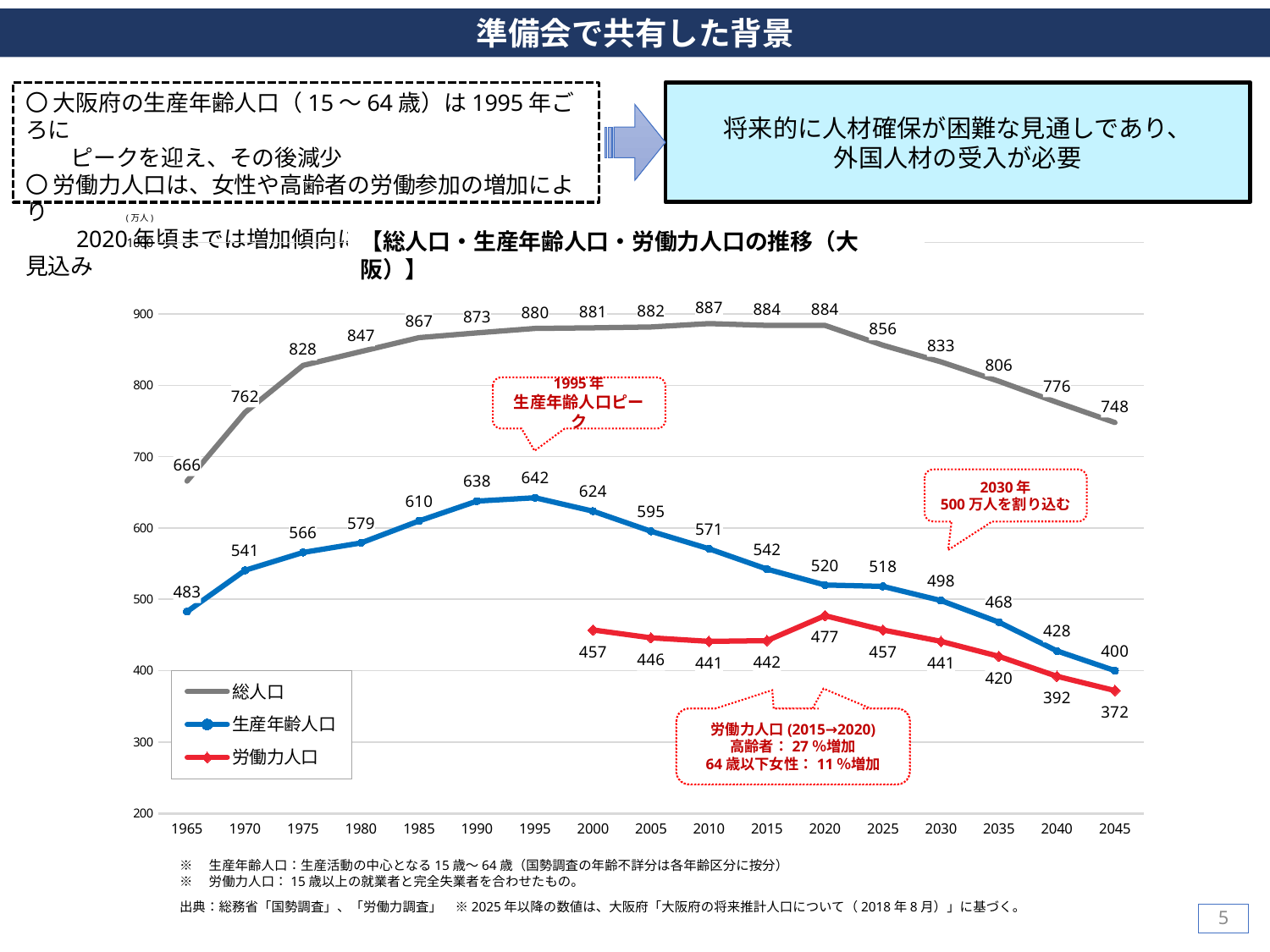
What kind of chart is shown on the slide? line chart How many series does the legend list? 3 In which year is 総人口 at its lowest value? 1965 What is the value of 総人口 in 2010? 887 How many years are shown on the x axis? 17 What is the value of 労働力人口 in 2020? 477 What is the difference between 総人口 and 生産年齢人口 in 2045? 348 What is the value of 生産年齢人口 in 1995? 642 What is the difference between 生産年齢人口 in 1995 and in 2045? 242 In which year does 生産年齢人口 reach its highest value? 1995 Does 総人口 rise or fall between 2020 and 2045? fall Which is larger in 2030: 生産年齢人口 or 労働力人口? 生産年齢人口